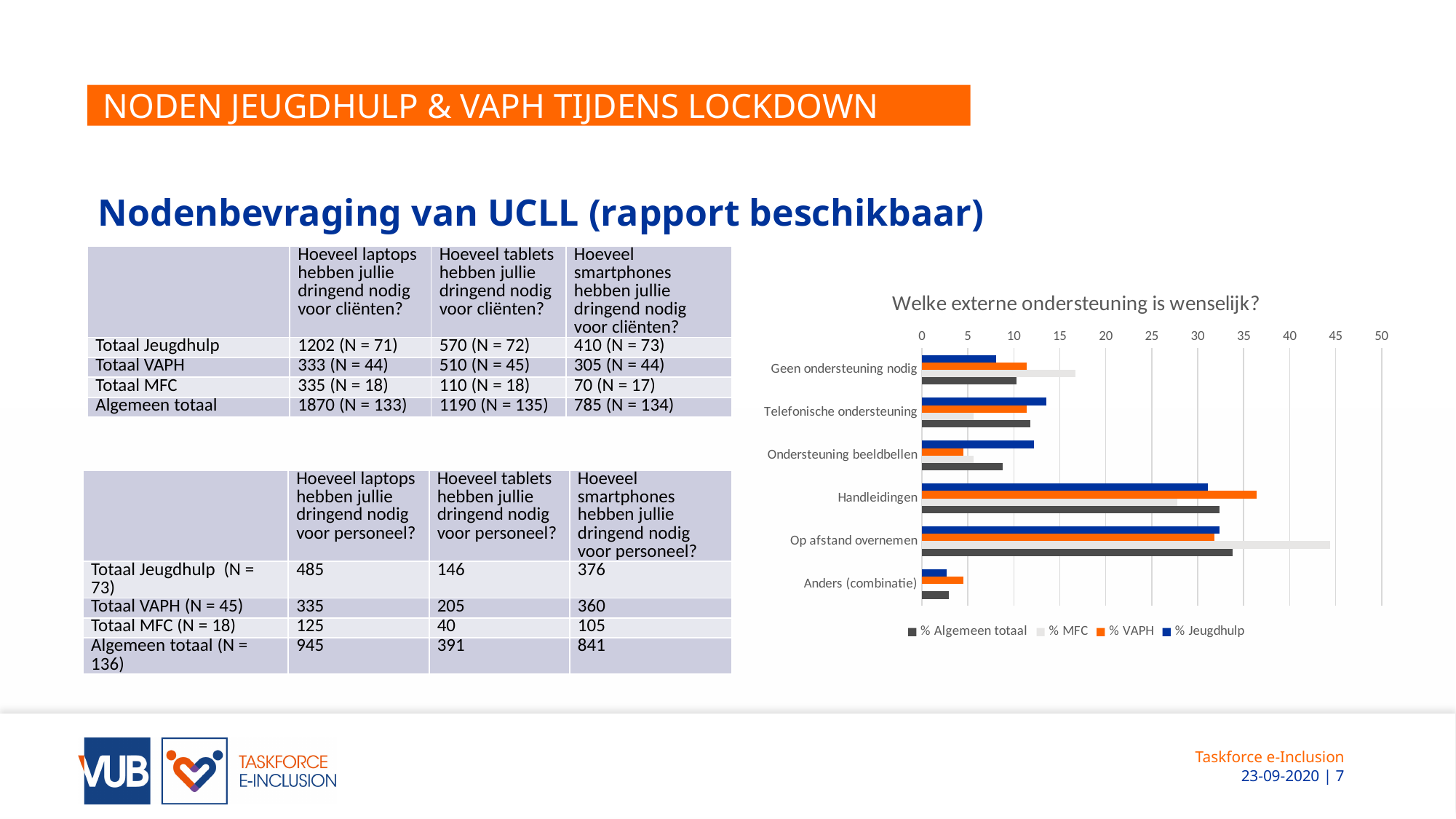
How many series does the legend of the chart 'Welke externe ondersteuning is wenselijk?' list? 4 In the chart 'Welke externe ondersteuning is wenselijk?', which is larger for 'Ondersteuning beeldbellen': the % Jeugdhulp value or the % VAPH value? % Jeugdhulp In the chart 'Welke externe ondersteuning is wenselijk?', is the % Jeugdhulp value for 'Geen ondersteuning nodig' greater or less than 10? less How many categories are shown on the y axis of the chart 'Welke externe ondersteuning is wenselijk?'? 6 In the chart 'Welke externe ondersteuning is wenselijk?', which is larger for 'Geen ondersteuning nodig': the % MFC value or the % Jeugdhulp value? % MFC In the chart 'Welke externe ondersteuning is wenselijk?', is the % MFC value for 'Op afstand overnemen' greater or less than 40? greater What kind of chart is 'Welke externe ondersteuning is wenselijk?'? bar chart In the chart 'Welke externe ondersteuning is wenselijk?', is the % VAPH value for 'Handleidingen' greater or less than 35? greater In the chart 'Welke externe ondersteuning is wenselijk?', which category has the highest value for the % VAPH series? Handleidingen In the chart 'Welke externe ondersteuning is wenselijk?', which category has the lowest value for the % Jeugdhulp series? Anders (combinatie) In the chart 'Welke externe ondersteuning is wenselijk?', which category has the highest value for the % MFC series? Op afstand overnemen What is the title of the bar chart on the right side of the slide? Welke externe ondersteuning is wenselijk?